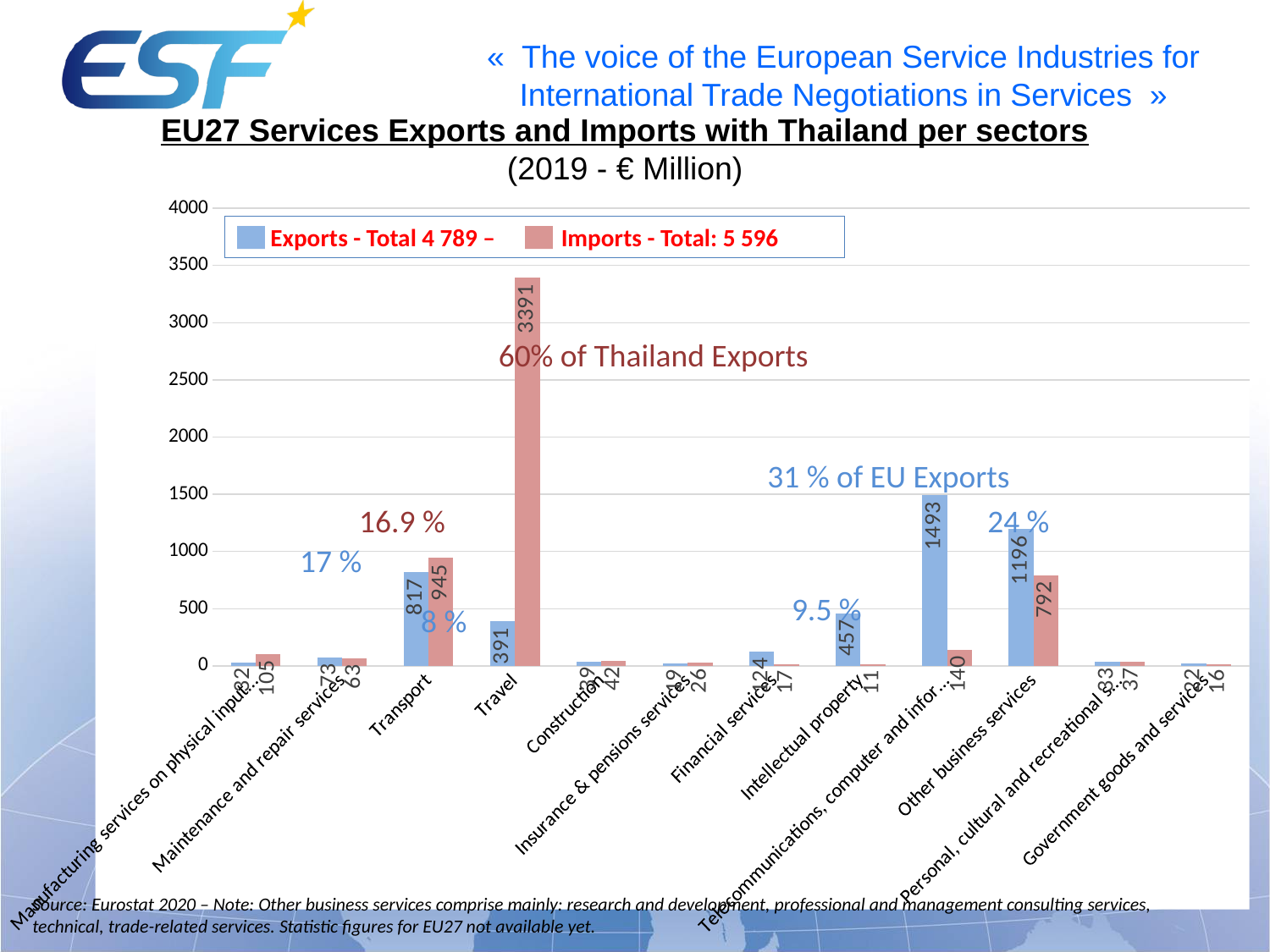
What is the Exports value for Intellectual property? 457 What is the Imports value for Travel? 3391 Which sector has the highest Exports value? Telecommunications, computer and infor... How many sectors are shown on the x axis? 12 What is the difference between Imports and Exports for Travel? 3000 What is the difference between Imports and Exports for Transport? 128 What is the Exports value for Transport? 817 What kind of chart is shown on the slide? bar chart Which sector has the highest Imports value? Travel According to the legend, what is the total for Imports? 5 596 For Other business services, which is larger, Exports or Imports? Exports How many series does the legend list? 2